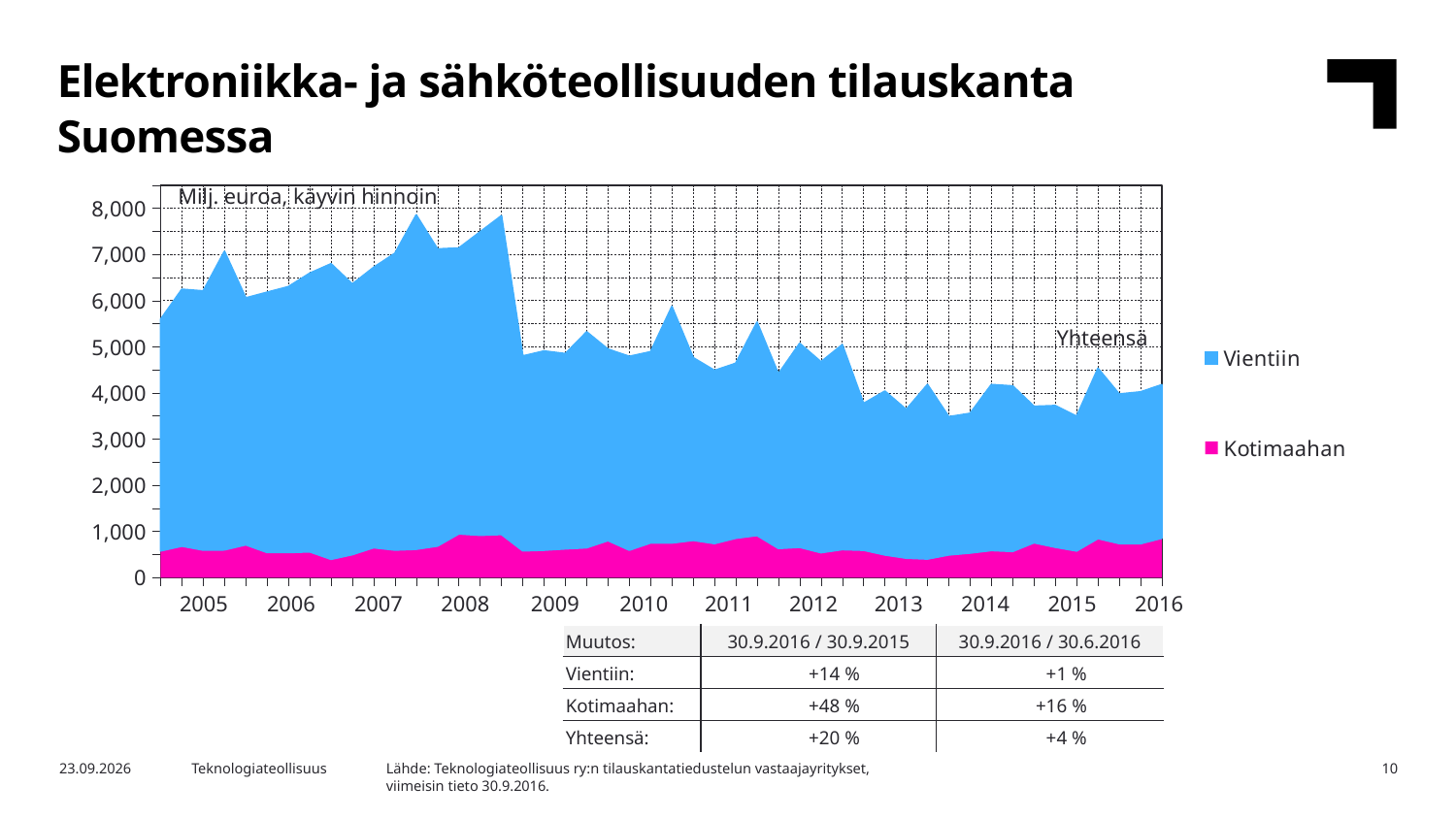
What are the two series named in the chart legend? Vientiin and Kotimaahan How many series does the chart legend list? 2 What unit label is printed at the top of the chart's plot area? Milj. euroa, käyvin hinnoin What kind of chart is shown on the slide? Stacked area chart Is the Kotimaahan value in 2012 greater or less than 1,000? less Is the total value at the start of 2009 greater or less than 6,000? less Is the peak total value in 2008 greater or less than 7,000? greater How many years are labelled on the x axis of the chart? 12 Which series is larger throughout the chart, Vientiin or Kotimaahan? Vientiin Does the total order backlog rise or fall between 2008 and 2009? fall